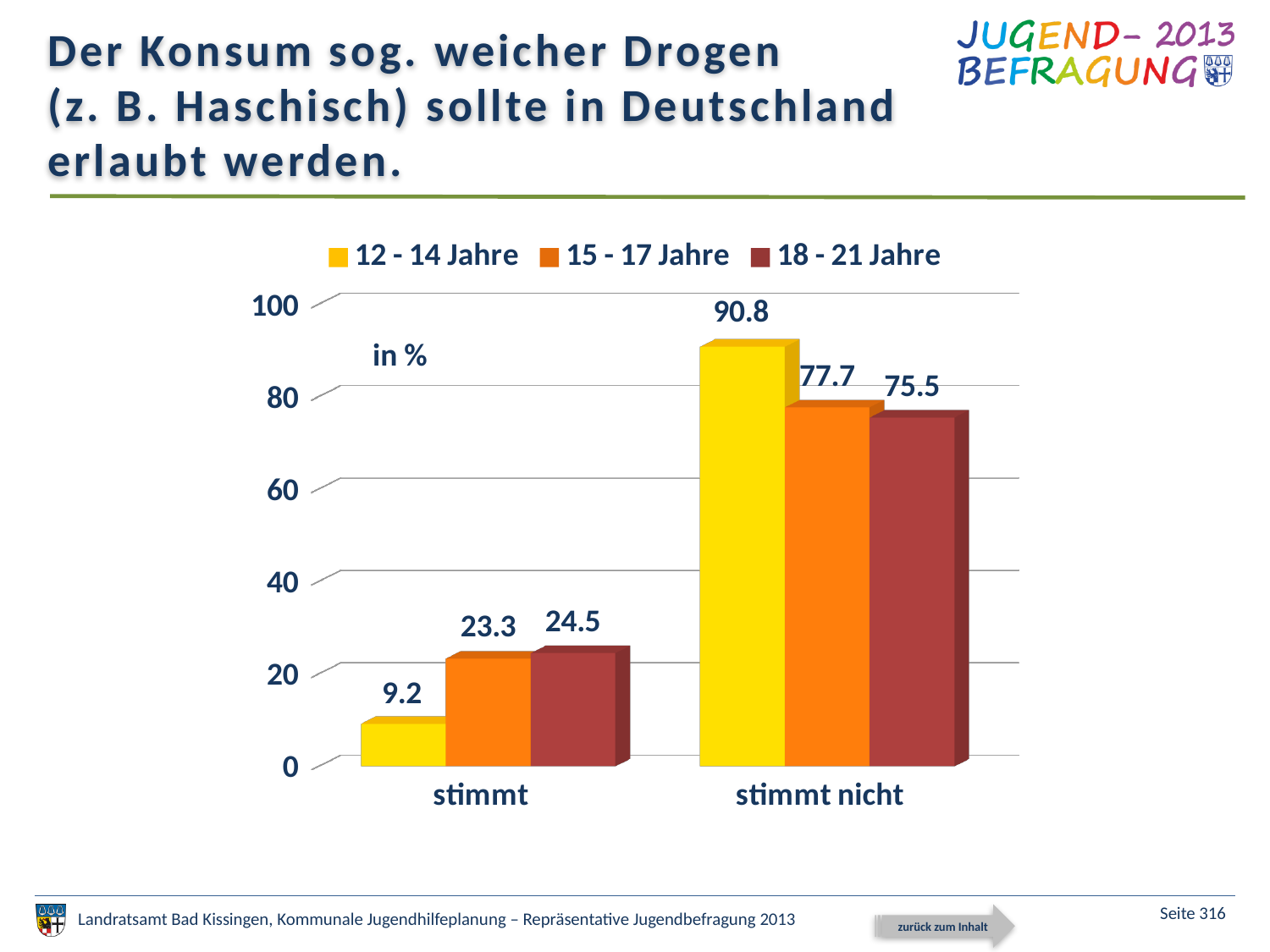
What is the value for the 12 - 14 Jahre series in the "stimmt" category? 9.2 How many series does the legend list? 3 What is the value for the 18 - 21 Jahre series in the "stimmt nicht" category? 75.5 What kind of chart is shown on the slide? bar chart What is the difference between the 15 - 17 Jahre and 18 - 21 Jahre values in the "stimmt nicht" category? 2.2 Which age group has the highest value in the "stimmt nicht" category? 12 - 14 Jahre Is the value for 15 - 17 Jahre in the "stimmt nicht" category greater or less than 80? less What is the difference between the 12 - 14 Jahre values for "stimmt nicht" and "stimmt"? 81.6 Which is larger: the 18 - 21 Jahre value for "stimmt" or the 15 - 17 Jahre value for "stimmt"? 18 - 21 Jahre Which age group has the lowest value in the "stimmt" category? 12 - 14 Jahre What is the value for the 15 - 17 Jahre series in the "stimmt" category? 23.3 How many categories are shown on the x axis? 2